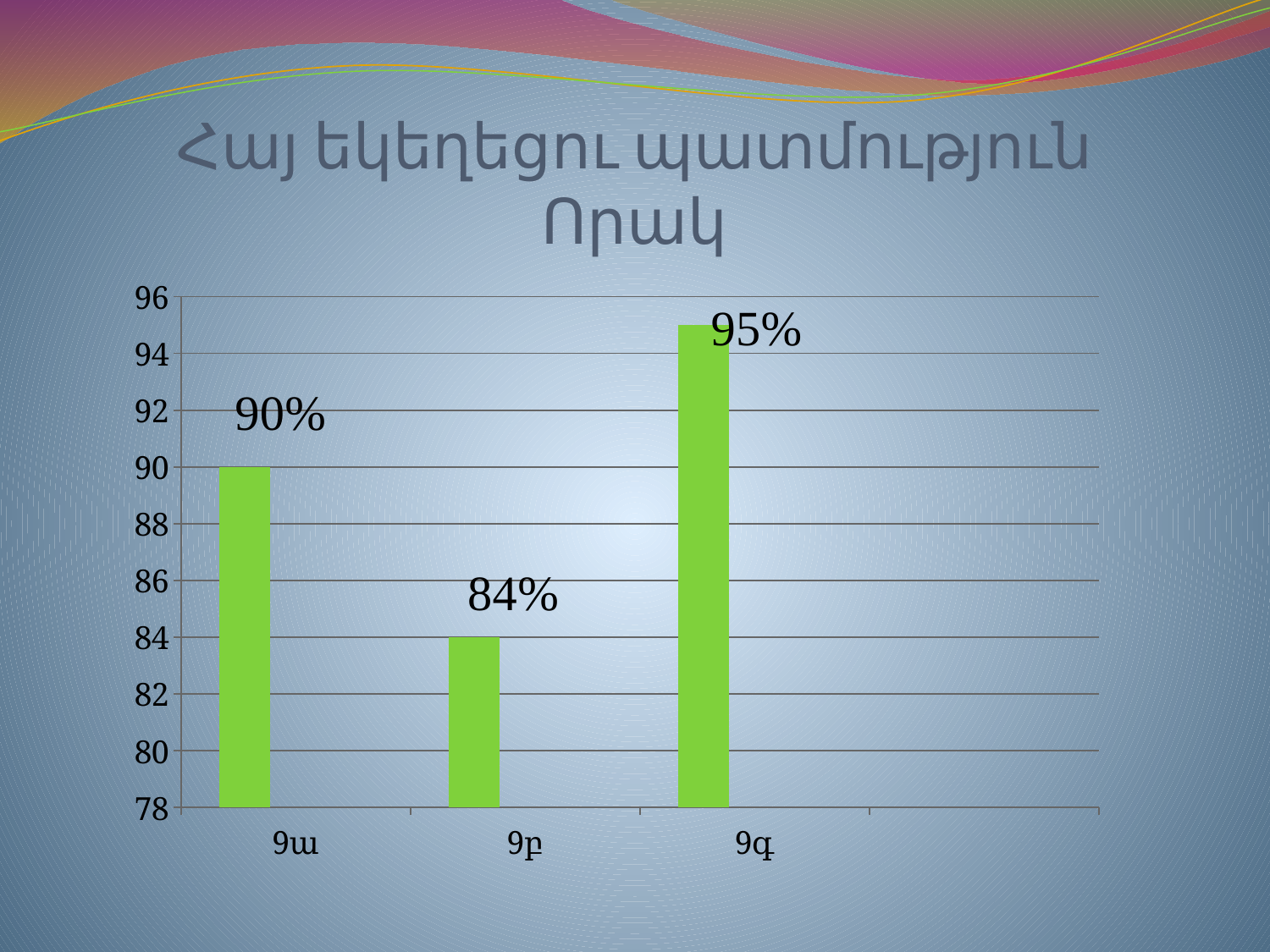
What colour are the bars in the chart? green Which is larger, the value for 9ա or the value for 9գ? 9գ What is the value for 9գ? 95% Is the value for 9բ greater or less than 86? less What is the difference between the values for 9ա and 9բ? 6% What is the difference between the values for 9գ and 9բ? 11% What is the value for 9բ? 84% What is the value for 9ա? 90% How many categories are shown on the x axis? 3 Which category has the lowest value? 9բ What kind of chart is shown on the slide? bar chart Which category has the highest value? 9գ